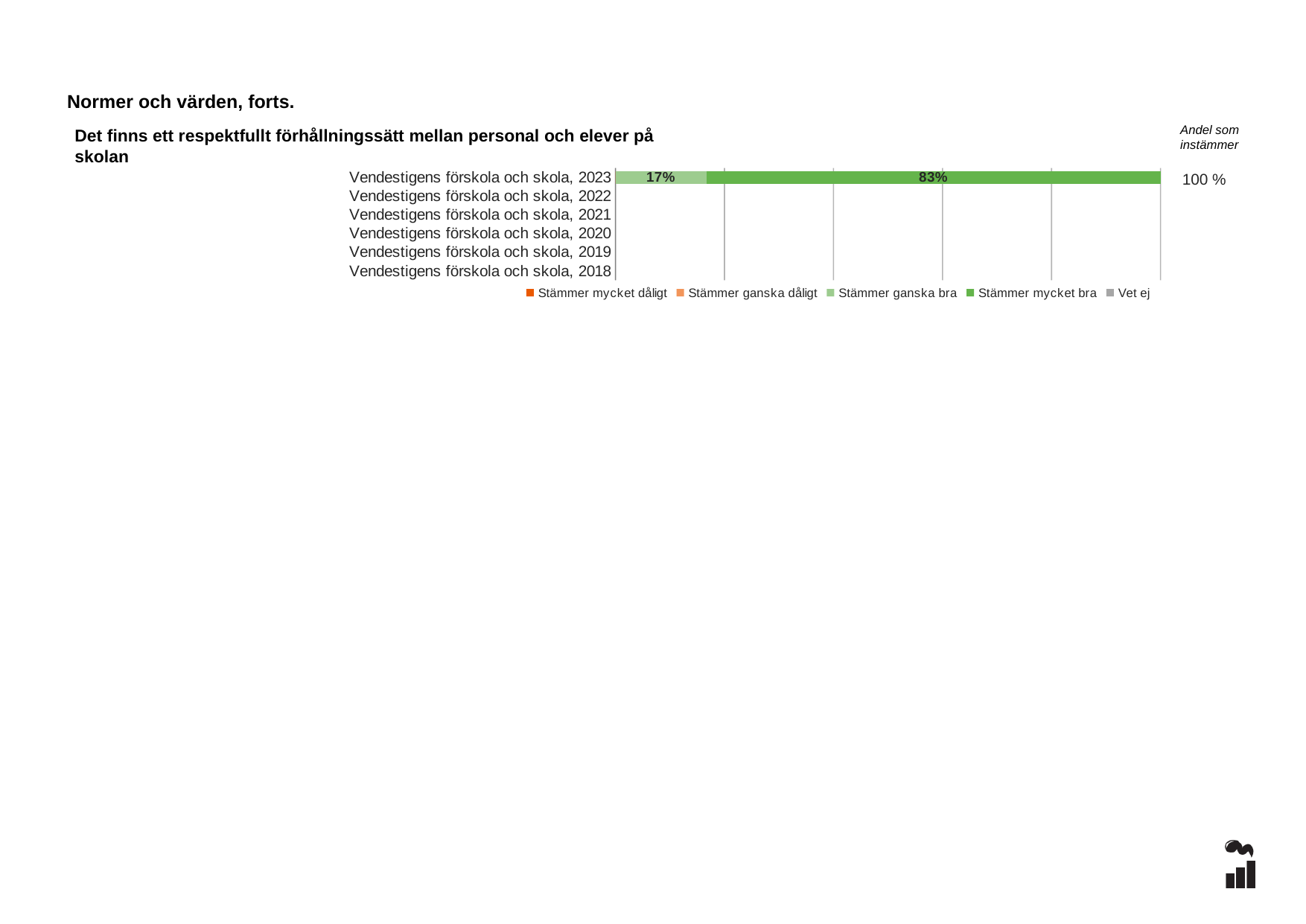
What is the total of the stacked bar for Vendestigens förskola och skola, 2023? 100% How many series does the legend list? 5 Which year is the only one with a plotted bar in the chart? 2023 What kind of chart is shown on the slide? bar chart What is the last entry in the chart's legend? Vet ej What is the value for "Stämmer mycket bra" for Vendestigens förskola och skola, 2023? 83% Which is larger for Vendestigens förskola och skola, 2023: "Stämmer ganska bra" or "Stämmer mycket bra"? Stämmer mycket bra What is the difference between the "Stämmer mycket bra" and "Stämmer ganska bra" values for Vendestigens förskola och skola, 2023? 66% What is the value for "Stämmer ganska bra" for Vendestigens förskola och skola, 2023? 17% How many category rows are listed on the y axis of the chart? 6 What is the "Andel som instämmer" value shown for Vendestigens förskola och skola, 2023? 100 %